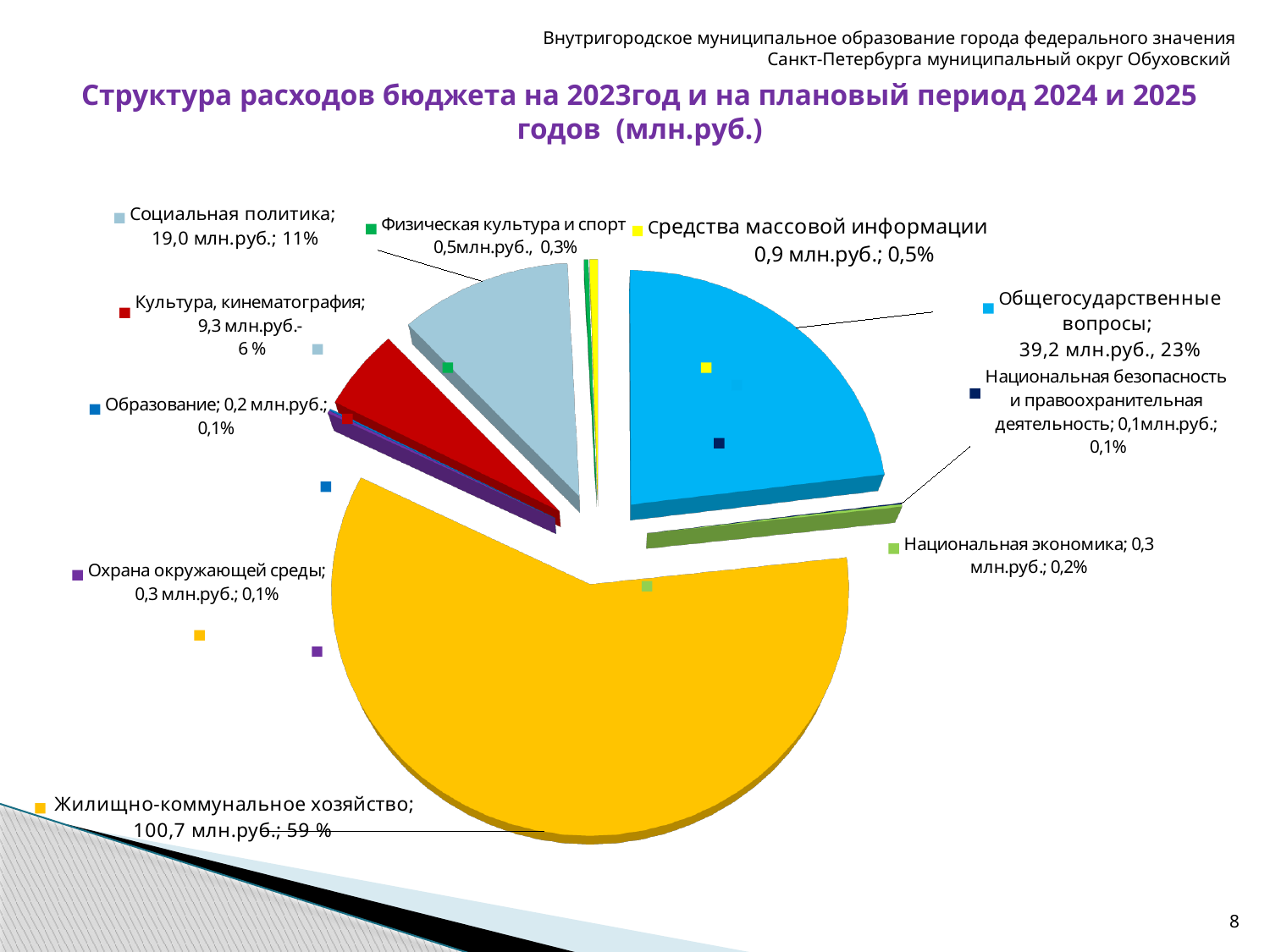
What kind of chart is shown on the slide? pie chart Which category has the largest value? Жилищно-коммунальное хозяйство What is the value for Культура, кинематография? 9,3 млн.руб. What share of the pie does Общегосударственные вопросы take? 23% Which is larger, the value for Социальная политика or the value for Культура, кинематография? Социальная политика What share of the pie does Жилищно-коммунальное хозяйство take? 59 % What is the difference between the values for Жилищно-коммунальное хозяйство and Общегосударственные вопросы? 61,5 млн.руб. What is the value for Общегосударственные вопросы? 39,2 млн.руб. Which category has the smallest value in млн.руб.? Национальная безопасность и правоохранительная деятельность How many categories does the pie chart show? 10 What is the value for Социальная политика? 19,0 млн.руб. What is the value for Жилищно-коммунальное хозяйство? 100,7 млн.руб.